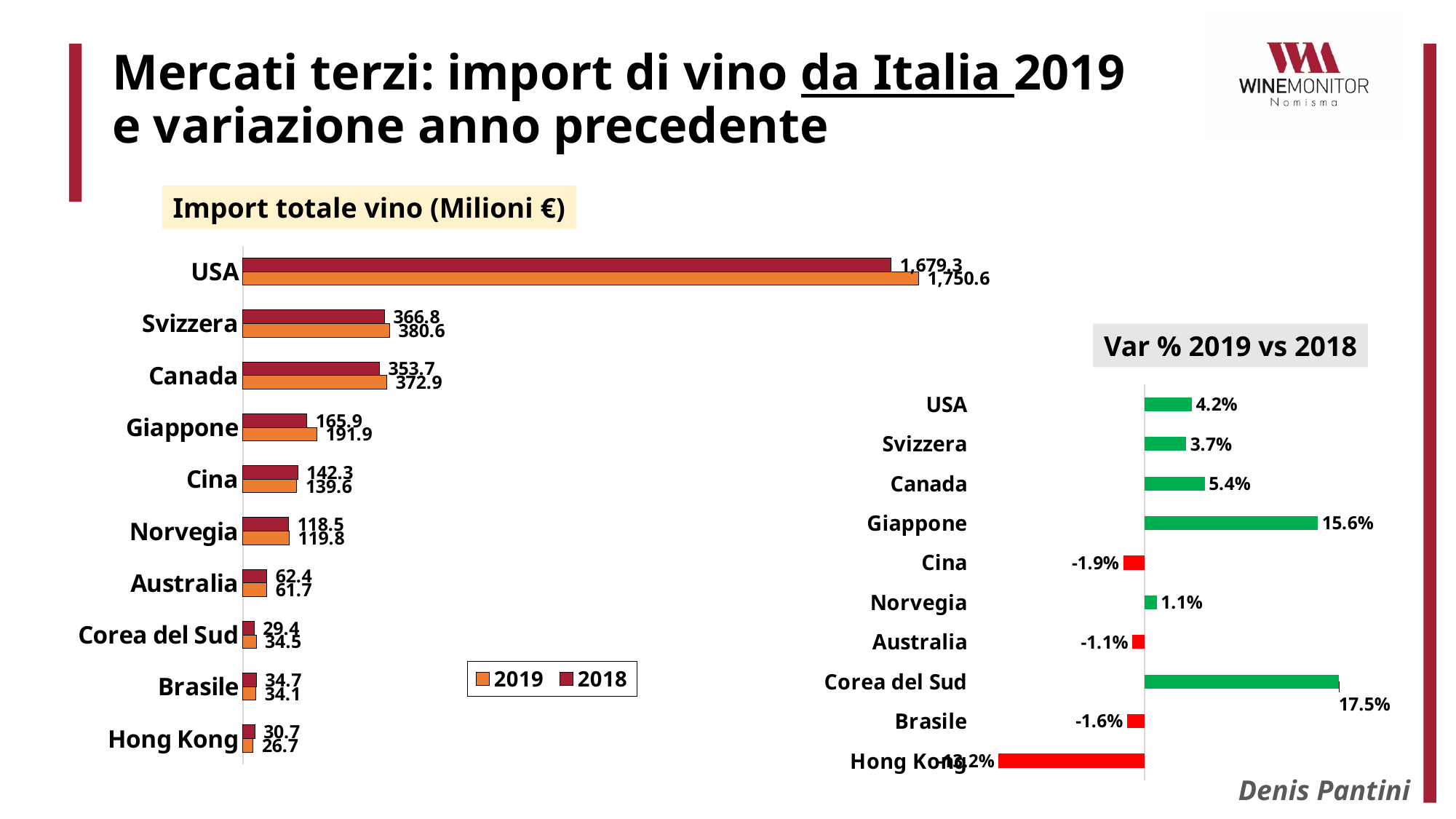
In the 'Var % 2019 vs 2018' chart, what is the value for Cina? -1.9% In the 'Var % 2019 vs 2018' chart, which country has the highest percentage change? Corea del Sud In the 'Import totale vino (Milioni €)' chart, what is the 2018 value for Giappone? 165.9 In the 'Var % 2019 vs 2018' chart, what is the value for Giappone? 15.6% In the 'Import totale vino (Milioni €)' chart, what is the 2019 value for USA? 1,750.6 In the 'Import totale vino (Milioni €)' chart, which is larger for Cina: the 2019 value or the 2018 value? 2018 How many series does the legend of the 'Import totale vino (Milioni €)' chart list? 2 In the 'Var % 2019 vs 2018' chart, what colour are the bars with negative values? Red In the 'Import totale vino (Milioni €)' chart, which country has the highest 2019 import value? USA How many countries are shown in the 'Import totale vino (Milioni €)' chart? 10 What kind of chart is the 'Var % 2019 vs 2018' chart? Bar chart In the 'Import totale vino (Milioni €)' chart, what is the difference between the 2019 and 2018 values for Canada? 19.2